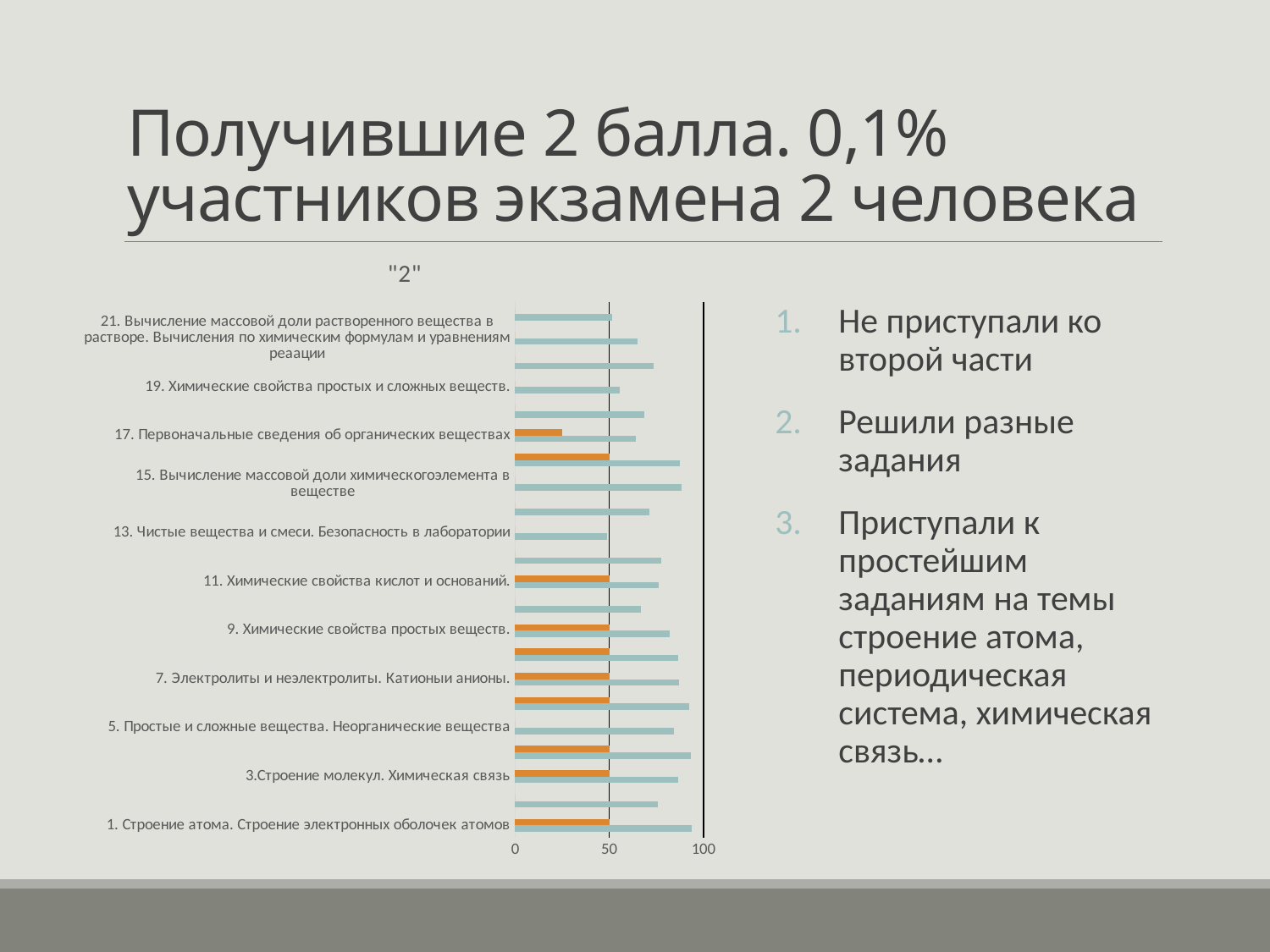
How many data series (bar colours) are plotted in the chart? 2 What is the title of the chart? "2" Is the blue-grey bar for "5. Простые и сложные вещества. Неорганические вещества" greater or less than 50? greater Which has the longer blue-grey bar: "1. Строение атома. Строение электронных оболочек атомов" or "13. Чистые вещества и смеси. Безопасность в лаборатории"? 1. Строение атома. Строение электронных оболочек атомов How many categories are plotted in the chart? 22 Is the blue-grey bar for "1. Строение атома. Строение электронных оболочек атомов" greater or less than 50? greater Is the orange bar for "17. Первоначальные сведения об органических веществах" greater or less than 50? less What kind of chart is shown on the slide? bar chart Which has the longer orange bar: "1. Строение атома. Строение электронных оболочек атомов" or "17. Первоначальные сведения об органических веществах"? 1. Строение атома. Строение электронных оболочек атомов What is the highest value shown on the chart's horizontal axis? 100 Which has the longer blue-grey bar: "5. Простые и сложные вещества. Неорганические вещества" or "19. Химические свойства простых и сложных веществ."? 5. Простые и сложные вещества. Неорганические вещества